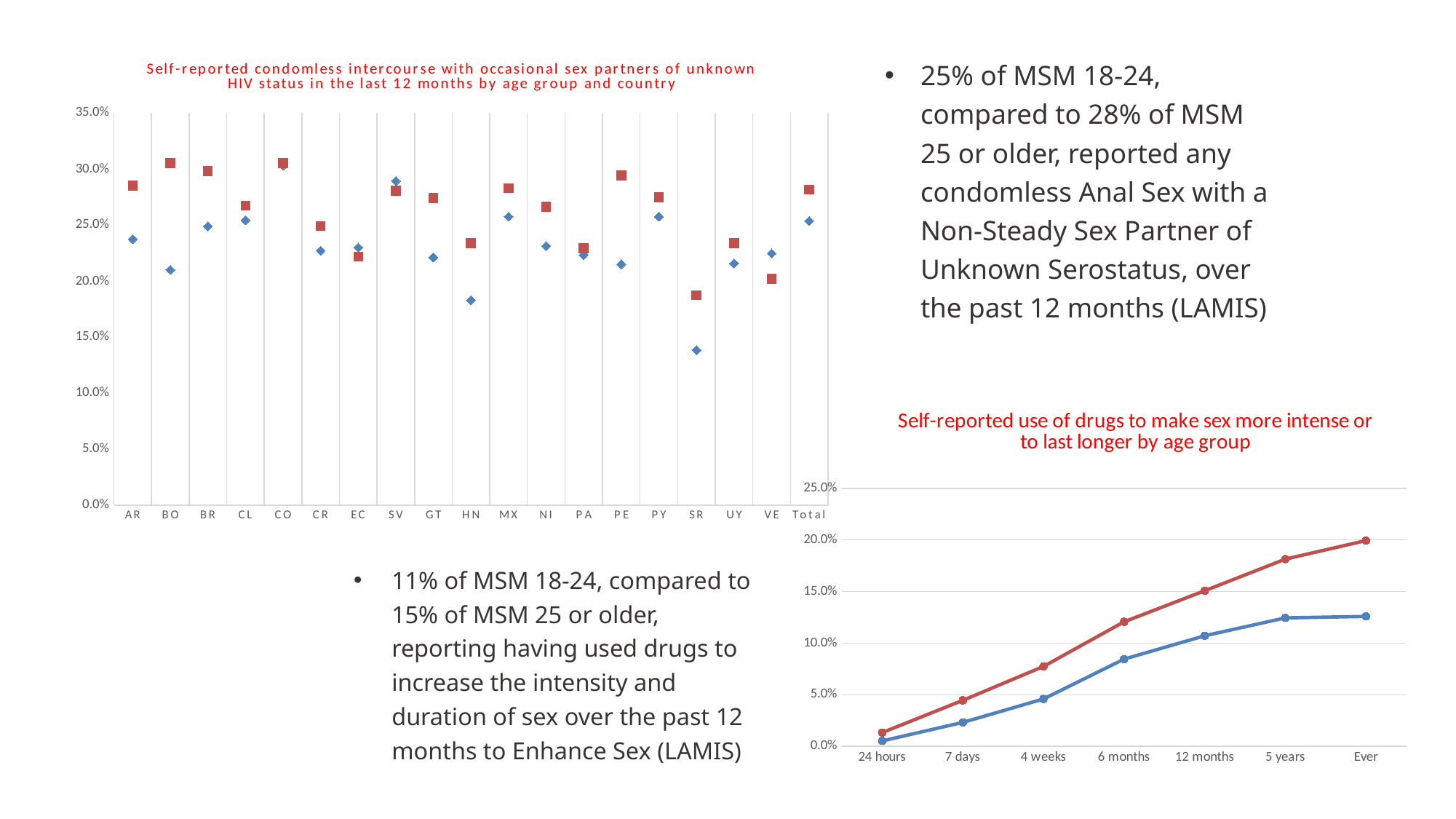
On the chart titled 'Self-reported condomless intercourse with occasional sex partners of unknown HIV status in the last 12 months by age group and country', is the blue diamond value for SR greater or less than 15.0%? less On the chart titled 'Self-reported condomless intercourse with occasional sex partners of unknown HIV status in the last 12 months by age group and country', is the blue diamond value for HN greater or less than 20.0%? less On the chart titled 'Self-reported condomless intercourse with occasional sex partners of unknown HIV status in the last 12 months by age group and country', is the red square value for Total greater or less than 25.0%? greater On the chart titled 'Self-reported condomless intercourse with occasional sex partners of unknown HIV status in the last 12 months by age group and country', how many categories are shown on the x axis? 19 What kind of chart is the chart titled 'Self-reported use of drugs to make sex more intense or to last longer by age group'? line chart On the chart titled 'Self-reported condomless intercourse with occasional sex partners of unknown HIV status in the last 12 months by age group and country', which category has the lowest red square value? SR On the chart titled 'Self-reported condomless intercourse with occasional sex partners of unknown HIV status in the last 12 months by age group and country', which is larger for BO, the red square value or the blue diamond value? the red square value On the chart titled 'Self-reported use of drugs to make sex more intense or to last longer by age group', how many points are shown on the x axis? 7 On the chart titled 'Self-reported use of drugs to make sex more intense or to last longer by age group', which line is higher at '5 years', the red line or the blue line? the red line On the chart titled 'Self-reported condomless intercourse with occasional sex partners of unknown HIV status in the last 12 months by age group and country', which category has the lowest blue diamond value? SR On the chart titled 'Self-reported use of drugs to make sex more intense or to last longer by age group', do the values rise or fall from '24 hours' to 'Ever'? rise